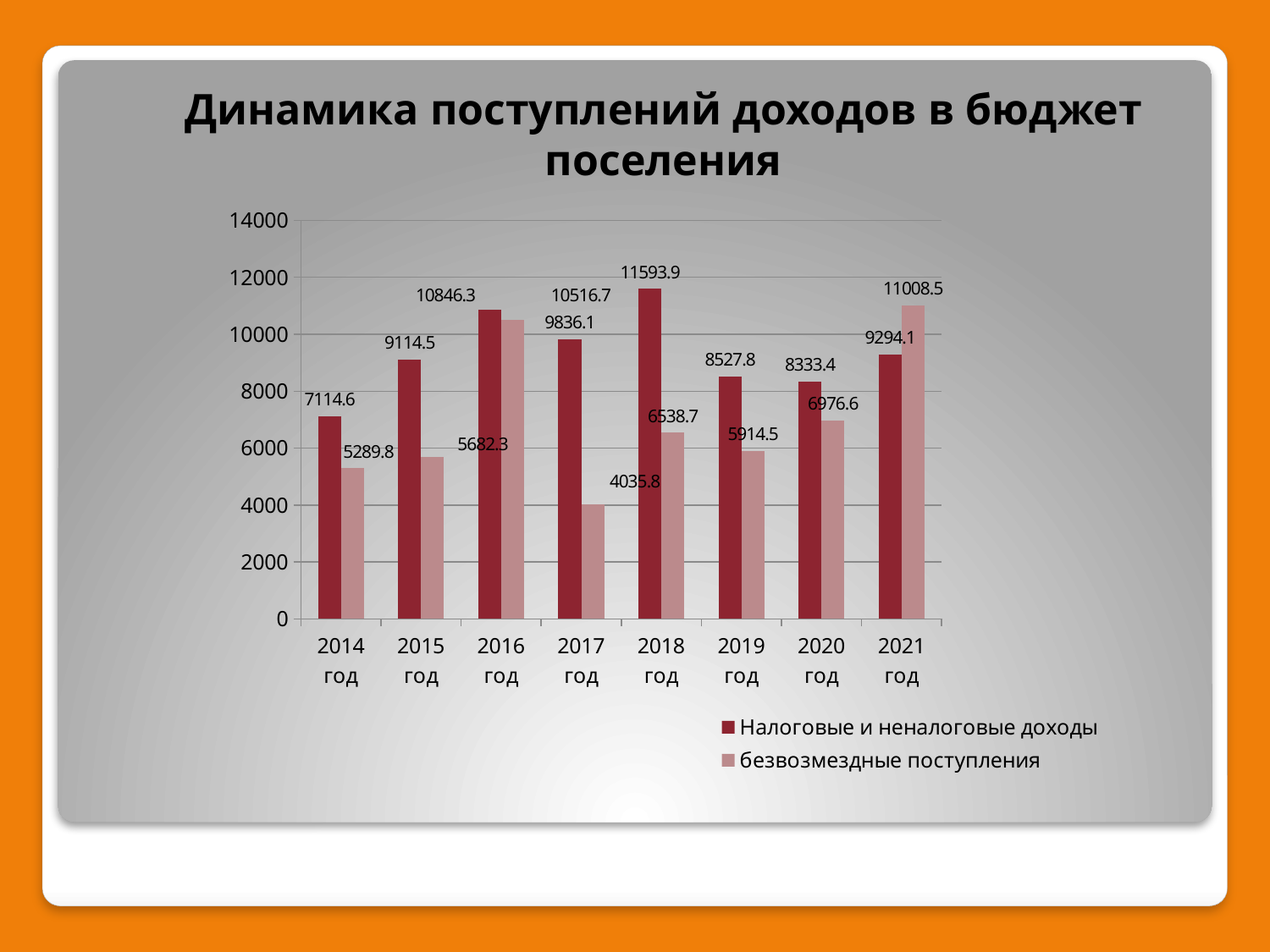
In which year is Налоговые и неналоговые доходы the highest? 2018 год Is the value of безвозмездные поступления for 2020 год greater or less than 6000? greater What is the value of Налоговые и неналоговые доходы for 2014 год? 7114.6 How many years are shown on the x axis? 8 How many series does the legend list? 2 In which year is Налоговые и неналоговые доходы the lowest? 2014 год Which is larger in 2021 год: Налоговые и неналоговые доходы or безвозмездные поступления? безвозмездные поступления What is the value of безвозмездные поступления for 2021 год? 11008.5 In which year is безвозмездные поступления the lowest? 2017 год What type of chart is shown on the slide? Bar chart What is the difference between Налоговые и неналоговые доходы and безвозмездные поступления in 2018 год? 5055.2 What is the value of безвозмездные поступления for 2017 год? 4035.8